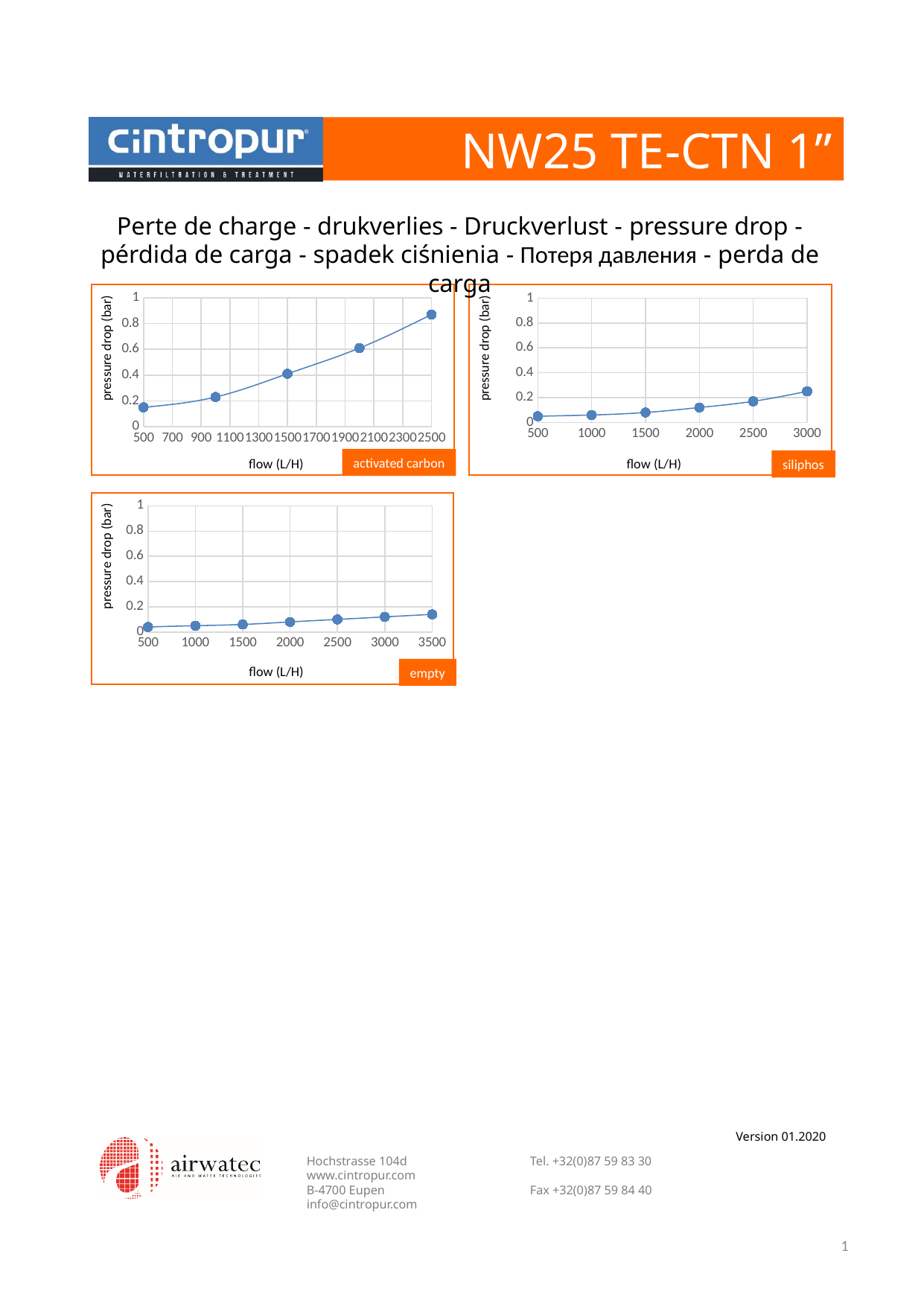
In the empty chart, how many data points are plotted? 7 In the activated carbon chart, does the pressure drop rise or fall as flow increases? rise In the activated carbon chart, at which flow value is the pressure drop highest? 2500 At 2500 L/H, which chart shows the larger pressure drop: activated carbon or siliphos? activated carbon What is the x-axis label on the empty chart? flow (L/H) In the siliphos chart, how many data points are plotted? 6 In the empty chart, is the pressure drop at 3500 L/H greater or less than 0.2 bar? less In the activated carbon chart, is the pressure drop at 2500 L/H greater or less than 0.8 bar? greater In the activated carbon chart, how many data points are plotted? 5 In the activated carbon chart, is the pressure drop at 500 L/H greater or less than 0.2 bar? less What kind of chart is the activated carbon chart? line chart